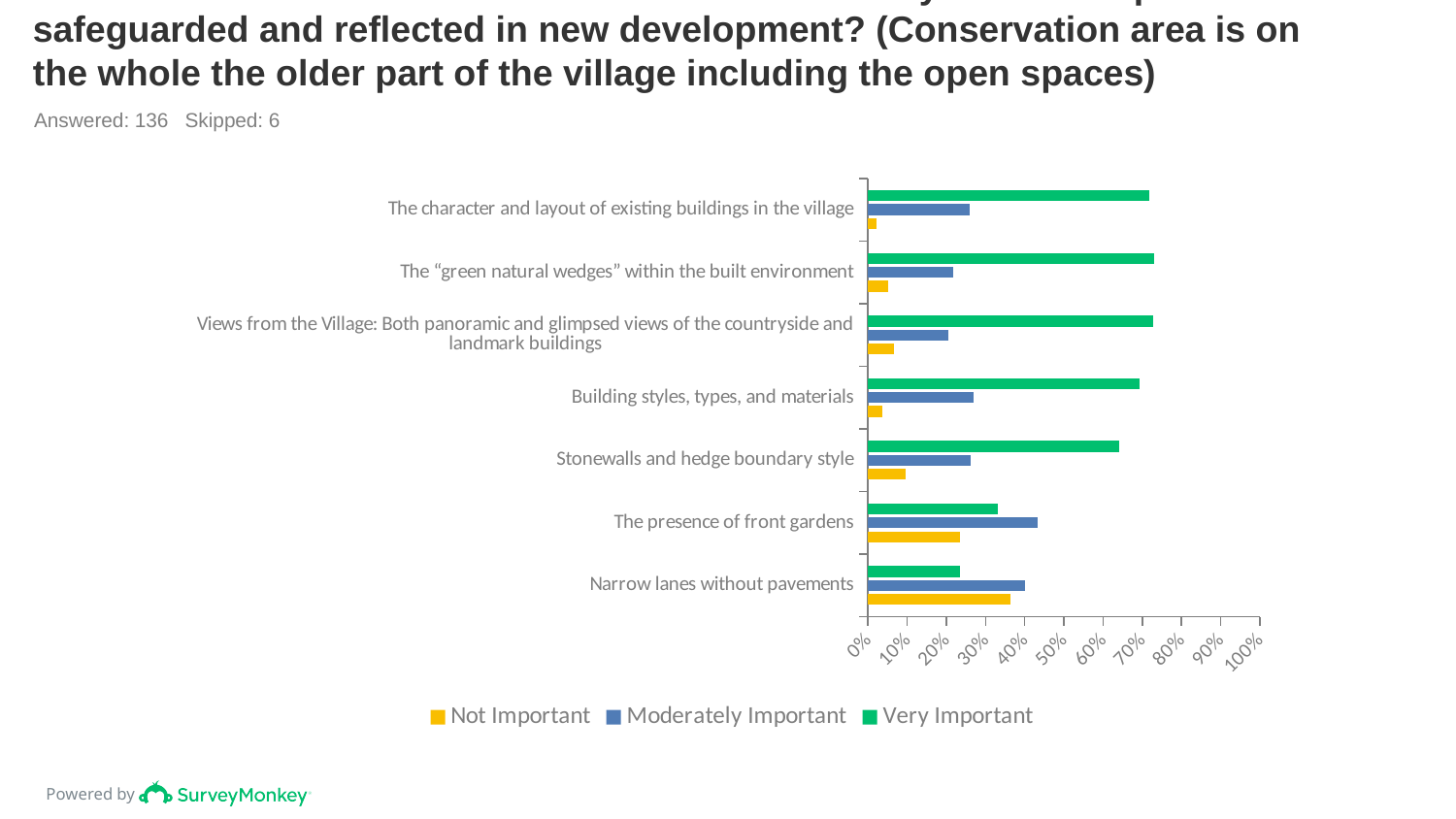
How many series does the legend list? 3 Is the Moderately Important value for The presence of front gardens greater or less than 30%? greater Is the Very Important value for Stonewalls and hedge boundary style greater or less than 50%? greater What colour represents the Very Important series in the legend? green How many categories (features) are plotted on the chart? 7 Which category has the highest Not Important value? Narrow lanes without pavements Is the Not Important value for The character and layout of existing buildings in the village greater or less than 10%? less Which category has the lowest Very Important value? Narrow lanes without pavements For Narrow lanes without pavements, which is larger: the Very Important value or the Moderately Important value? Moderately Important What kind of chart is shown on the slide? bar chart Which has the larger Not Important value: Narrow lanes without pavements or The presence of front gardens? Narrow lanes without pavements